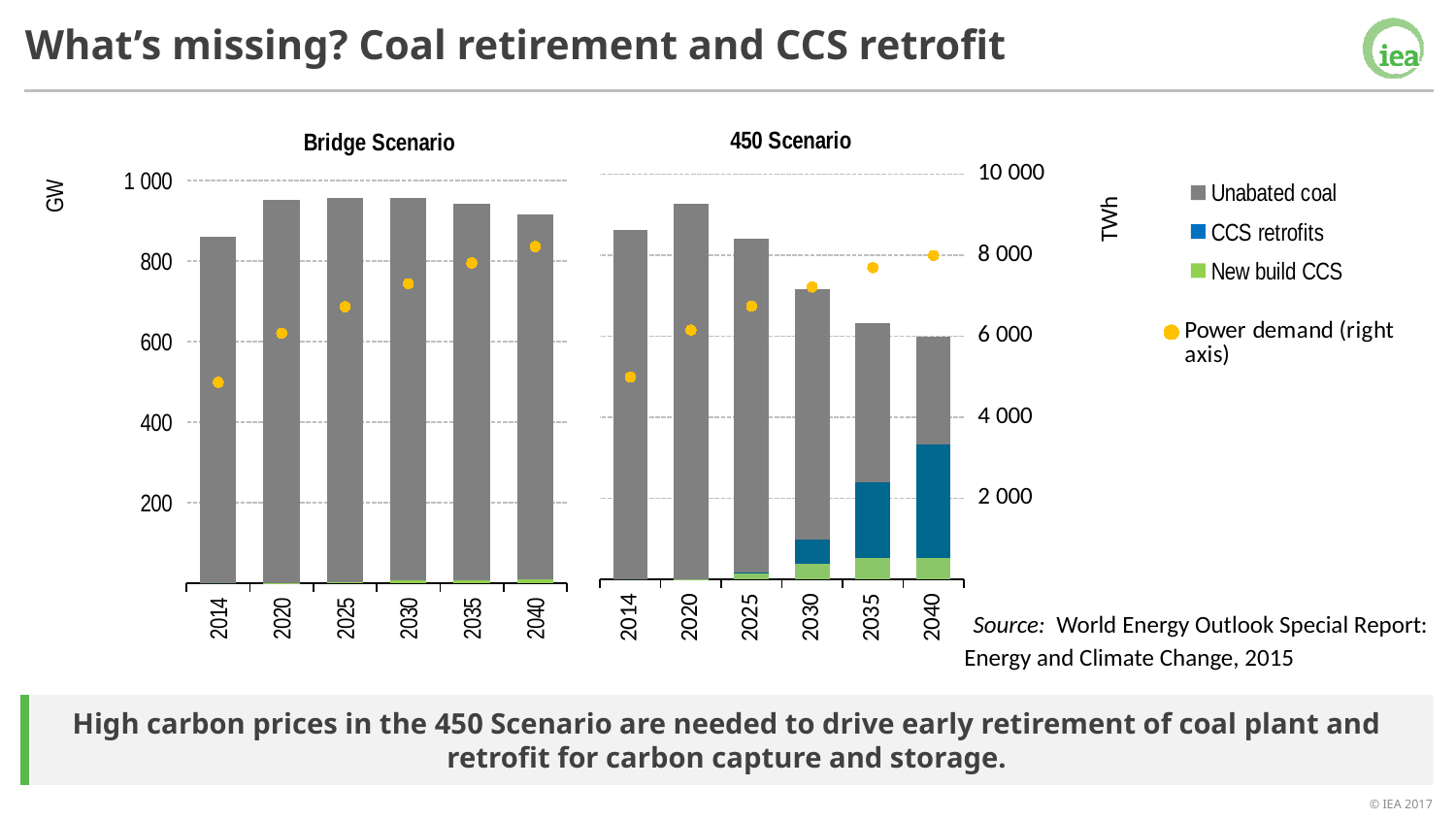
Which series is plotted on the right axis? Power demand In the 450 Scenario chart, which year has the highest total bar? 2020 How many series does the legend list? 4 How many years are shown on the x axis of the 450 Scenario chart? 6 What type of chart is used for the Bridge Scenario? Combination bar and line chart (stacked bars with power demand markers) What unit is shown on the left axis of the charts? GW In the 450 Scenario chart, does the total coal capacity rise or fall from 2020 to 2040? fall In the Bridge Scenario chart, is the total bar for 2014 greater or less than 800 GW? greater In the Bridge Scenario chart, which year has the lowest total bar? 2014 In the 450 Scenario chart, which year has the lowest total bar? 2040 In the 450 Scenario chart, is the total bar for 2035 greater or less than 800 GW? less In the 450 Scenario chart, is the power demand for 2014 greater or less than 6 000 TWh? less